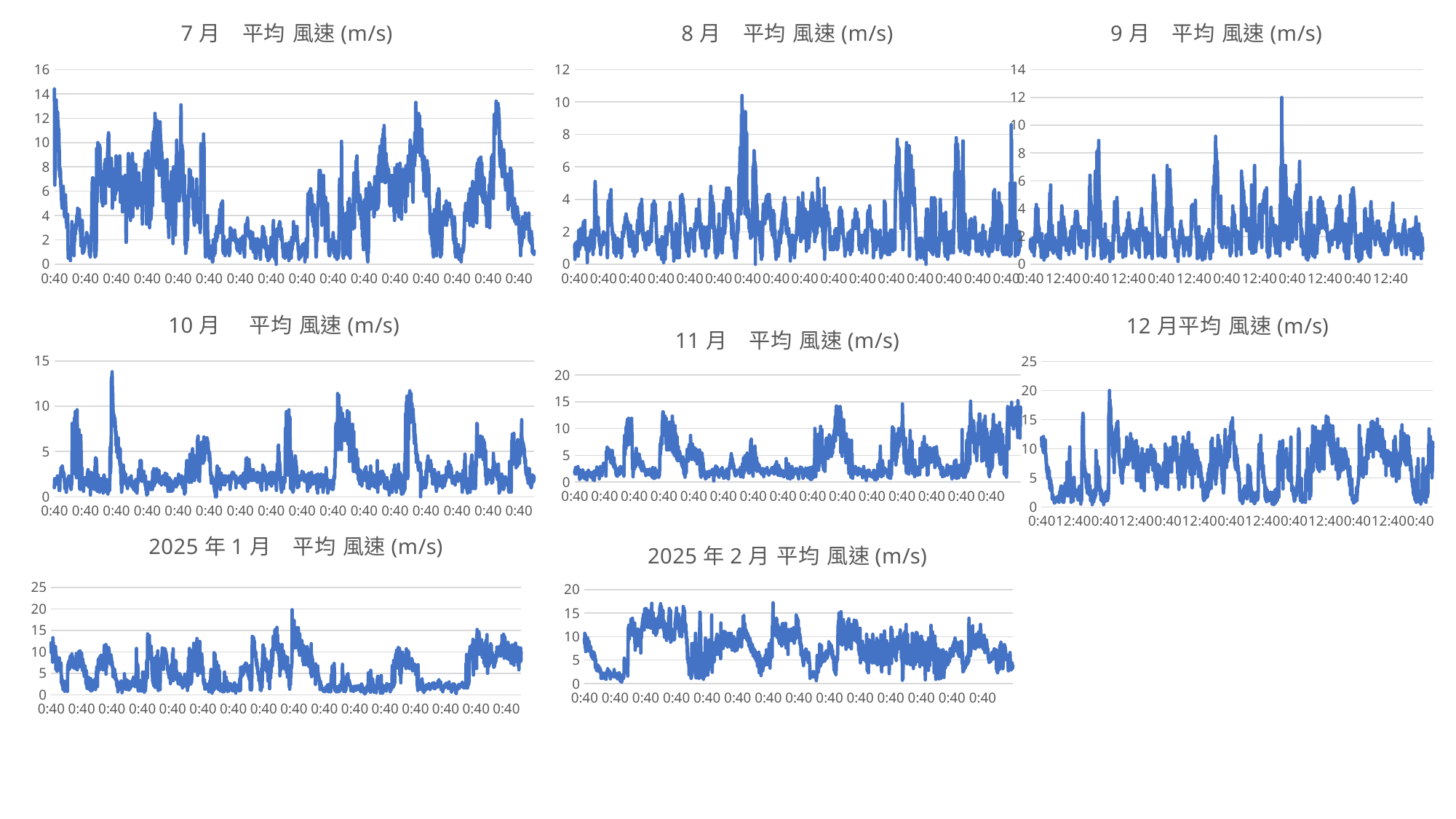
In the "9 月 平均 風速 (m/s)" chart, is the highest peak of the line greater or less than 10? greater How many charts are shown on the slide? 8 In the "12 月平均 風速 (m/s)" chart, what is the highest value shown on the vertical axis? 25 What is the title of the top-left chart? 7 月 平均 風速 (m/s) How many lines are plotted in the "11 月 平均 風速 (m/s)" chart? 1 In the "8 月 平均 風速 (m/s)" chart, is the highest peak of the line greater or less than 8? greater What kind of chart is used for the "7 月 平均 風速 (m/s)" chart? line chart In the "2025 年 2 月 平均 風速 (m/s)" chart, is the highest peak of the line greater or less than 15? greater In the "8 月 平均 風速 (m/s)" chart, what is the highest value shown on the vertical axis? 12 In the "7 月 平均 風速 (m/s)" chart, what is the highest value shown on the vertical axis? 16